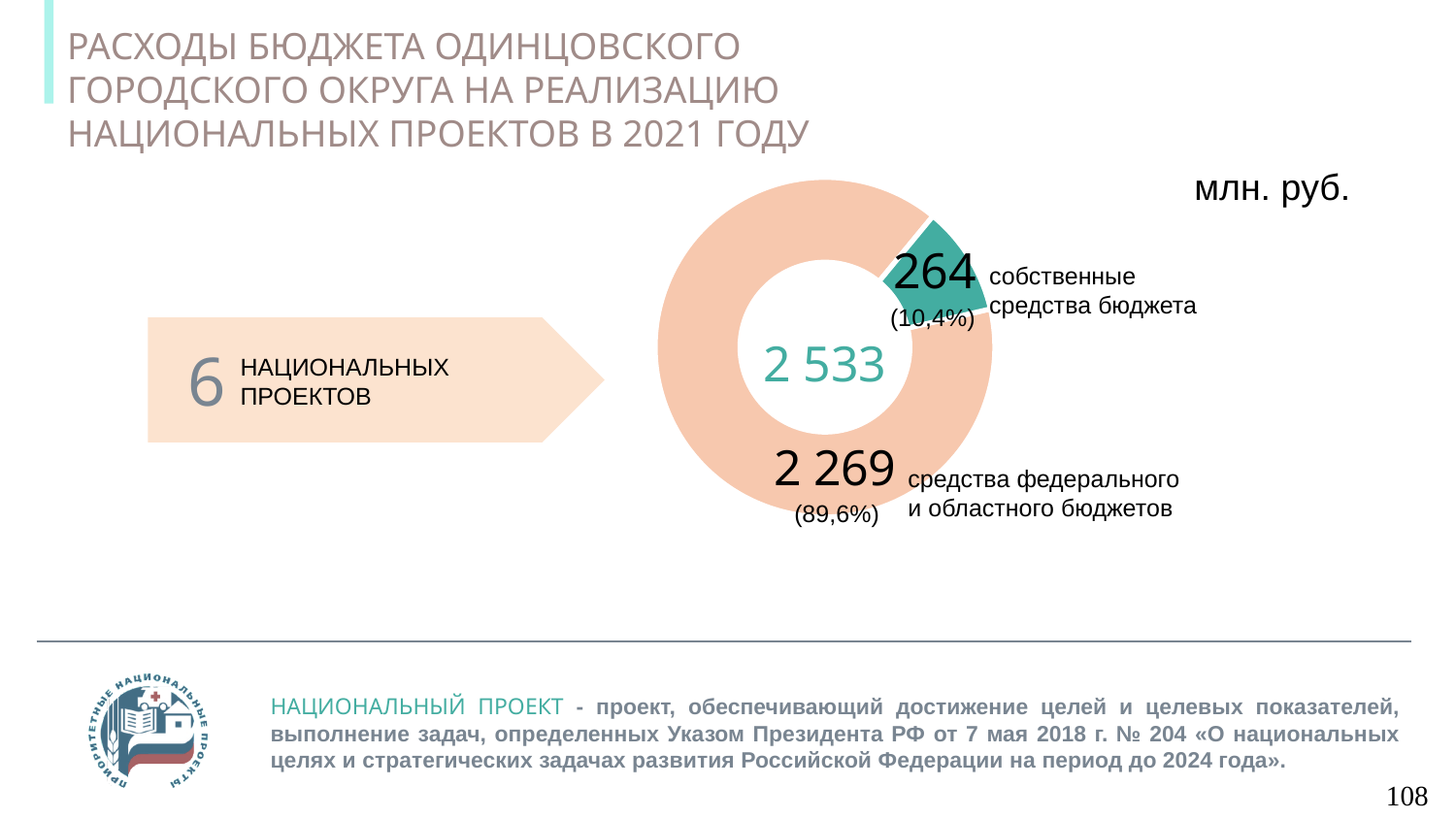
What is the value for средства федерального и областного бюджетов? 2 269 What is the value for собственные средства бюджета? 264 What kind of chart is shown on the slide? pie chart (donut) What share of the total do средства федерального и областного бюджетов make up? 89,6% Which is larger: собственные средства бюджета or средства федерального и областного бюджетов? средства федерального и областного бюджетов What total value is shown in the centre of the donut chart? 2 533 What share of the total do собственные средства бюджета make up? 10,4% How many slices does the donut chart have? 2 In what units are the chart values given? млн. руб. Which slice is the largest? средства федерального и областного бюджетов Which slice is the smallest? собственные средства бюджета What is the difference between средства федерального и областного бюджетов and собственные средства бюджета? 2 005